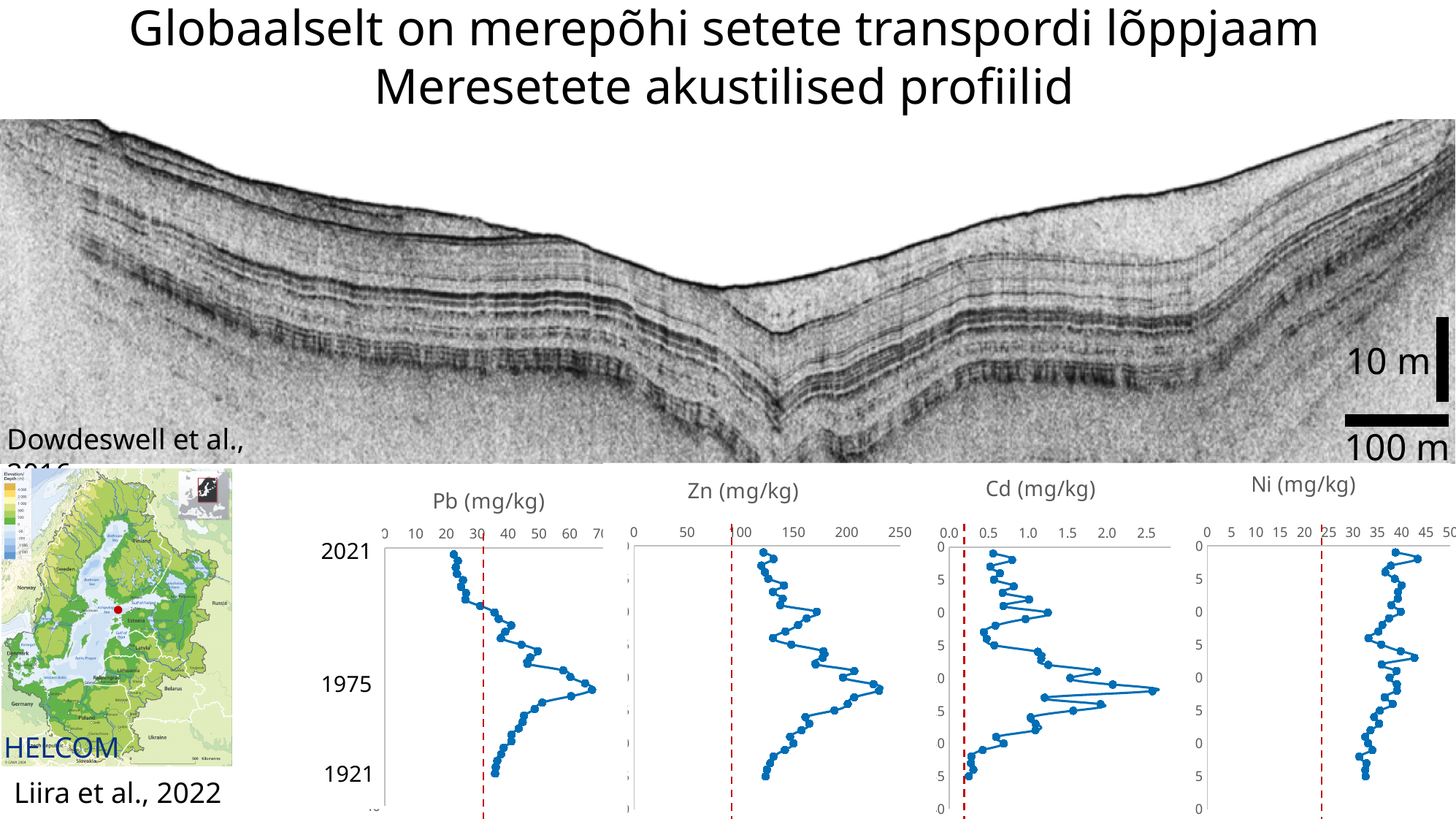
In the Cd (mg/kg) chart, is the value at 1921 greater or less than 0.5? less In the Pb (mg/kg) chart, is the value at 2021 greater or less than 30? less In the Zn (mg/kg) chart, is the value at 2021 greater or less than 150? less What kind of chart is the Pb (mg/kg) chart? line chart How many metal concentration charts are shown at the bottom of the slide? 4 What is the largest tick value on the x axis of the Zn (mg/kg) chart? 250 What colour is the dashed vertical reference line in each of the four charts? red Which of the four charts has the largest x-axis maximum tick value? Zn (mg/kg)